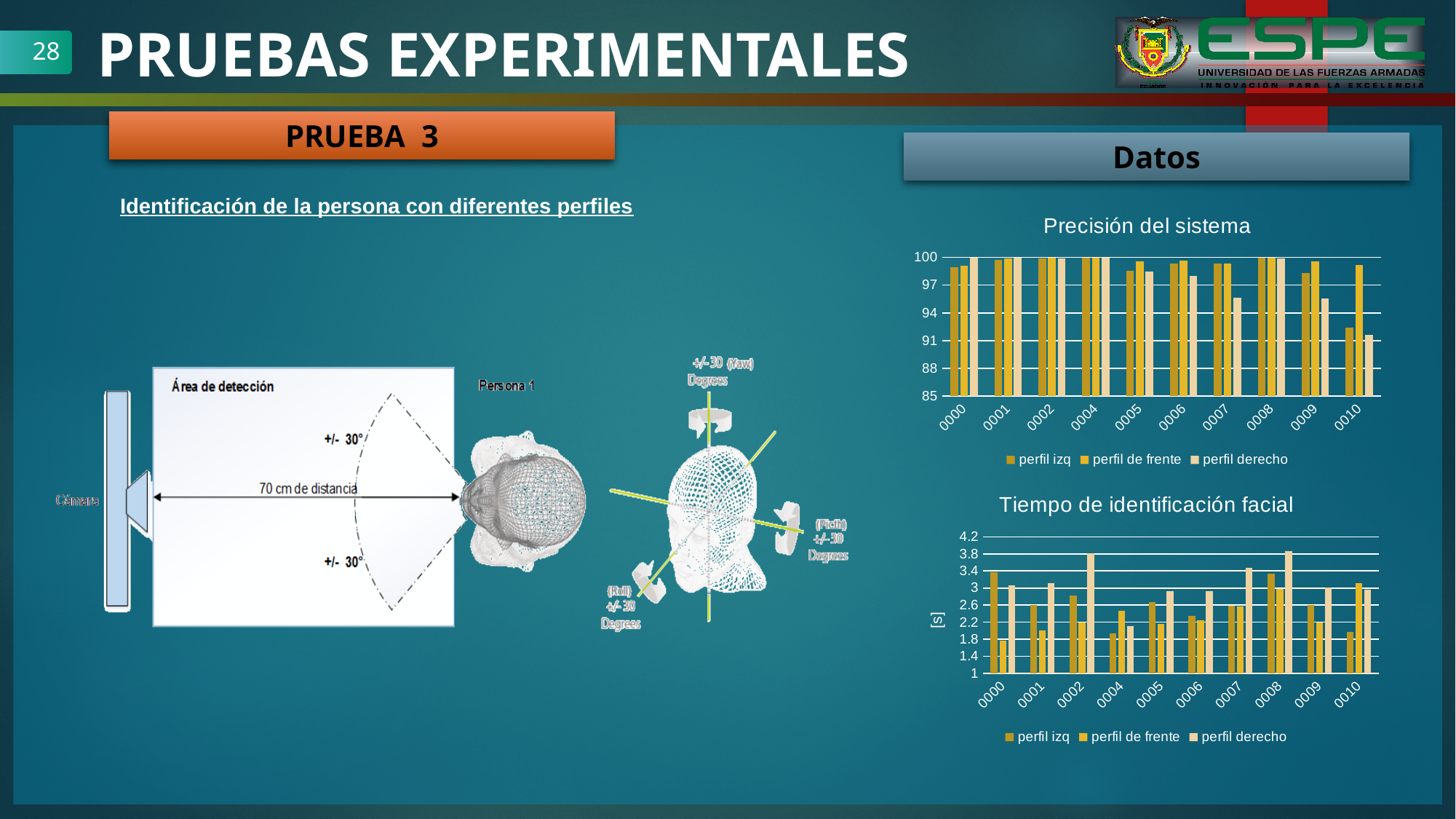
In the "Precisión del sistema" chart, at category 0010, which is larger: perfil de frente or perfil izq? perfil de frente In the "Precisión del sistema" chart, is the value for perfil izq at category 0010 greater or less than 94? less What kind of chart is the "Precisión del sistema" chart? bar chart How many series does the legend of the "Precisión del sistema" chart list? 3 What are the legend entries of the "Tiempo de identificación facial" chart? perfil izq, perfil de frente, perfil derecho What kind of chart is the "Tiempo de identificación facial" chart? bar chart What is the y-axis label of the "Tiempo de identificación facial" chart? [s] In the "Tiempo de identificación facial" chart, is the value for perfil de frente at category 0000 greater or less than 2.2? less In the "Tiempo de identificación facial" chart, is the value for perfil derecho at category 0008 greater or less than 3.4? greater How many categories are shown on the x axis of the "Precisión del sistema" chart? 10 In the "Tiempo de identificación facial" chart, at category 0000, which is larger: perfil izq or perfil de frente? perfil izq